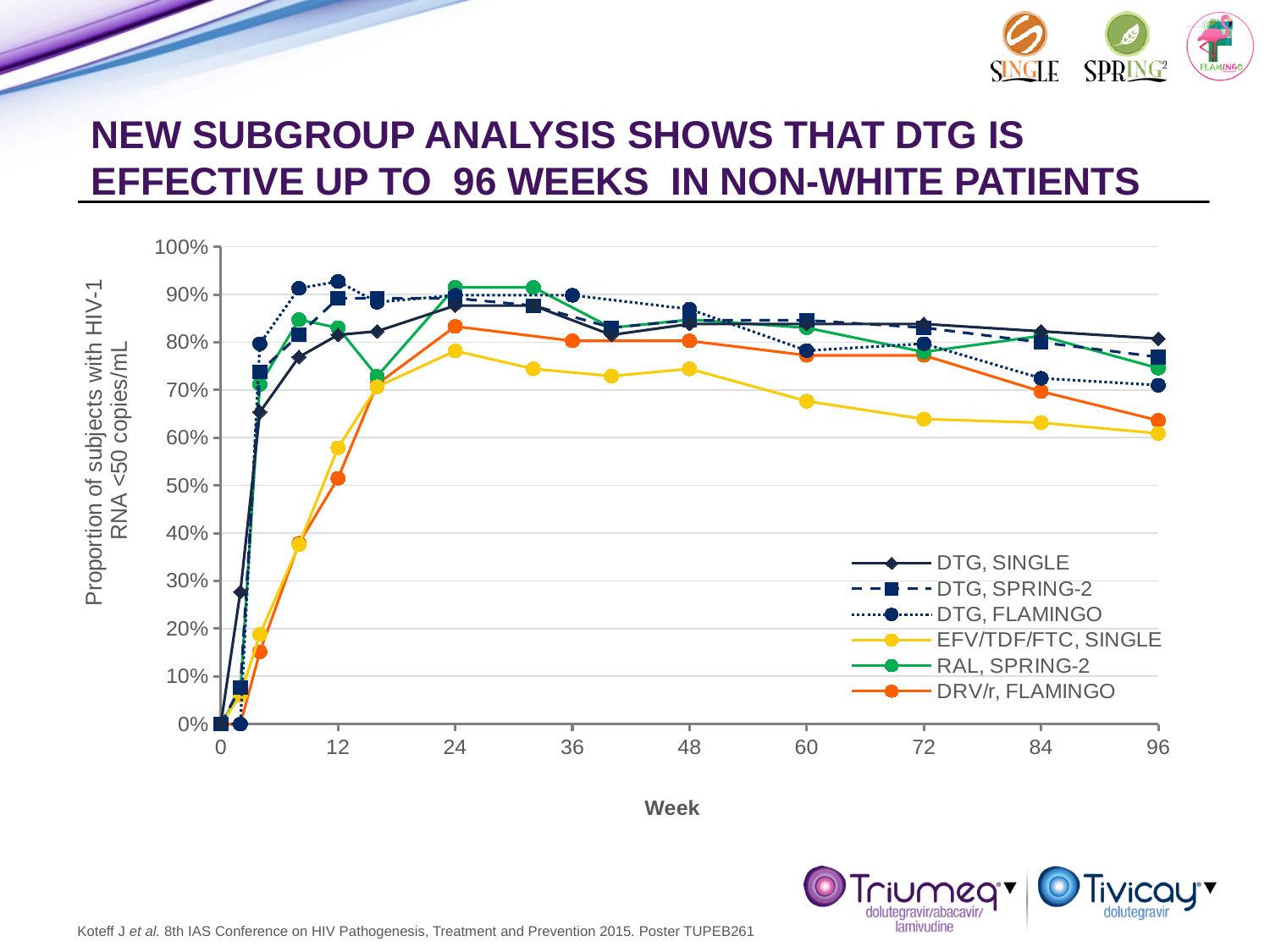
What is the value for DTG, SINGLE at week 0? 0% Is the value for DTG, FLAMINGO at week 12 greater or less than 90%? greater Which series has the lowest value at week 12? DRV/r, FLAMINGO What is the label of the x axis? Week Which series is drawn with a dotted line in the legend? DTG, FLAMINGO What kind of chart is shown on the slide? line chart Is the value for DRV/r, FLAMINGO at week 12 greater or less than 60%? less At week 96, which is larger: DTG, SINGLE or EFV/TDF/FTC, SINGLE? DTG, SINGLE Is the value for DTG, SINGLE at week 96 greater or less than 70%? greater How many series does the legend list? 6 At week 60, which is larger: EFV/TDF/FTC, SINGLE or DRV/r, FLAMINGO? DRV/r, FLAMINGO